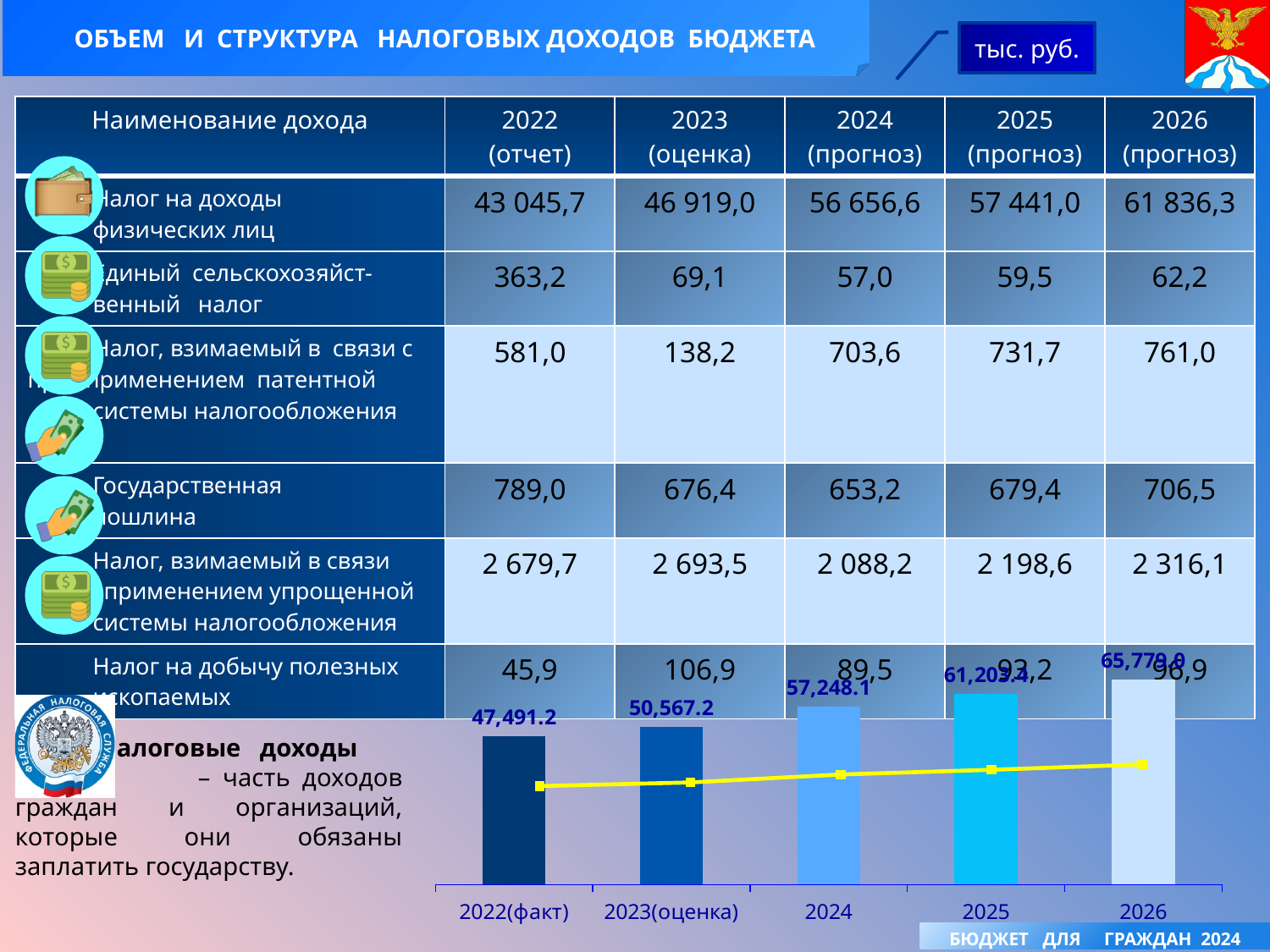
In the bar chart at the bottom of the slide, what is the difference between the values for 2023(оценка) and 2022(факт)? 3,076.0 What colour is the line drawn across the bars in the chart at the bottom of the slide? yellow In the bar chart at the bottom of the slide, what is the difference between the values for 2024 and 2023(оценка)? 6,680.9 In the bar chart at the bottom of the slide, what is the value for 2022(факт)? 47,491.2 What kind of chart is shown at the bottom of the slide? bar chart with a line In the bar chart at the bottom of the slide, which year has the shortest bar? 2022(факт) In the bar chart at the bottom of the slide, what is the value for 2023(оценка)? 50,567.2 In the bar chart at the bottom of the slide, which year has the tallest bar? 2026 In the bar chart at the bottom of the slide, what is the value for 2024? 57,248.1 In the bar chart at the bottom of the slide, which is larger: the value for 2024 or the value for 2023(оценка)? 2024 How many bars are shown in the bar chart at the bottom of the slide? 5 In the bar chart at the bottom of the slide, do the bar values rise or fall from 2022 to 2026? rise